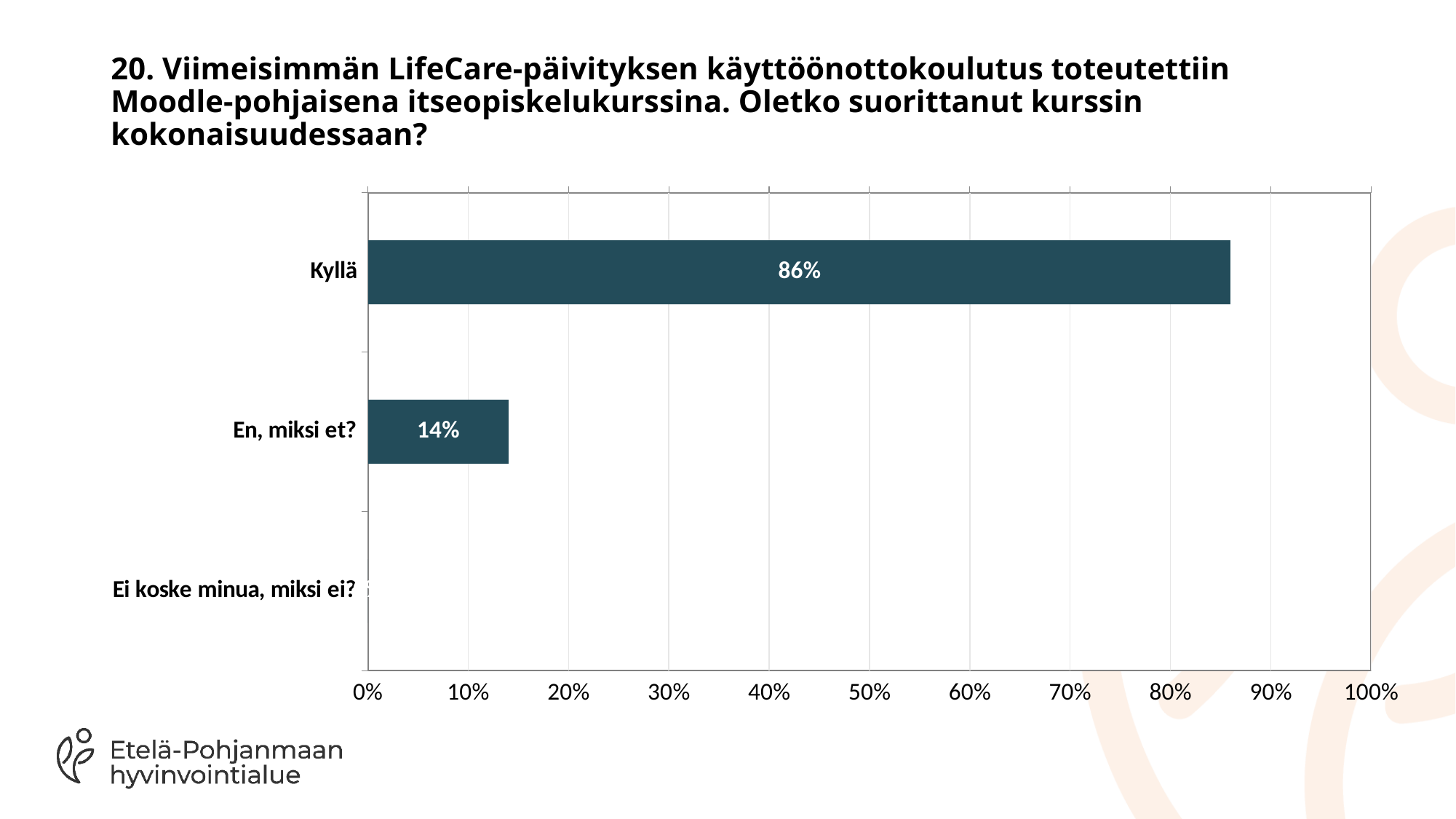
What is the difference between the values for "Kyllä" and "En, miksi et?"? 72% What percentage of respondents answered "En, miksi et?"? 14% Which category has the lowest value? Ei koske minua, miksi ei? What is the maximum value shown on the horizontal axis? 100% What percentage of respondents answered "Kyllä"? 86% Is the value for "Ei koske minua, miksi ei?" greater or less than 10%? less Is the value for "Kyllä" greater or less than 80%? greater How many categories are shown on the chart? 3 Which is larger, the value for "Kyllä" or the value for "En, miksi et?"? Kyllä What is the question number shown in the chart title? 20 Which category has the highest value? Kyllä What kind of chart is shown on the slide? Bar chart